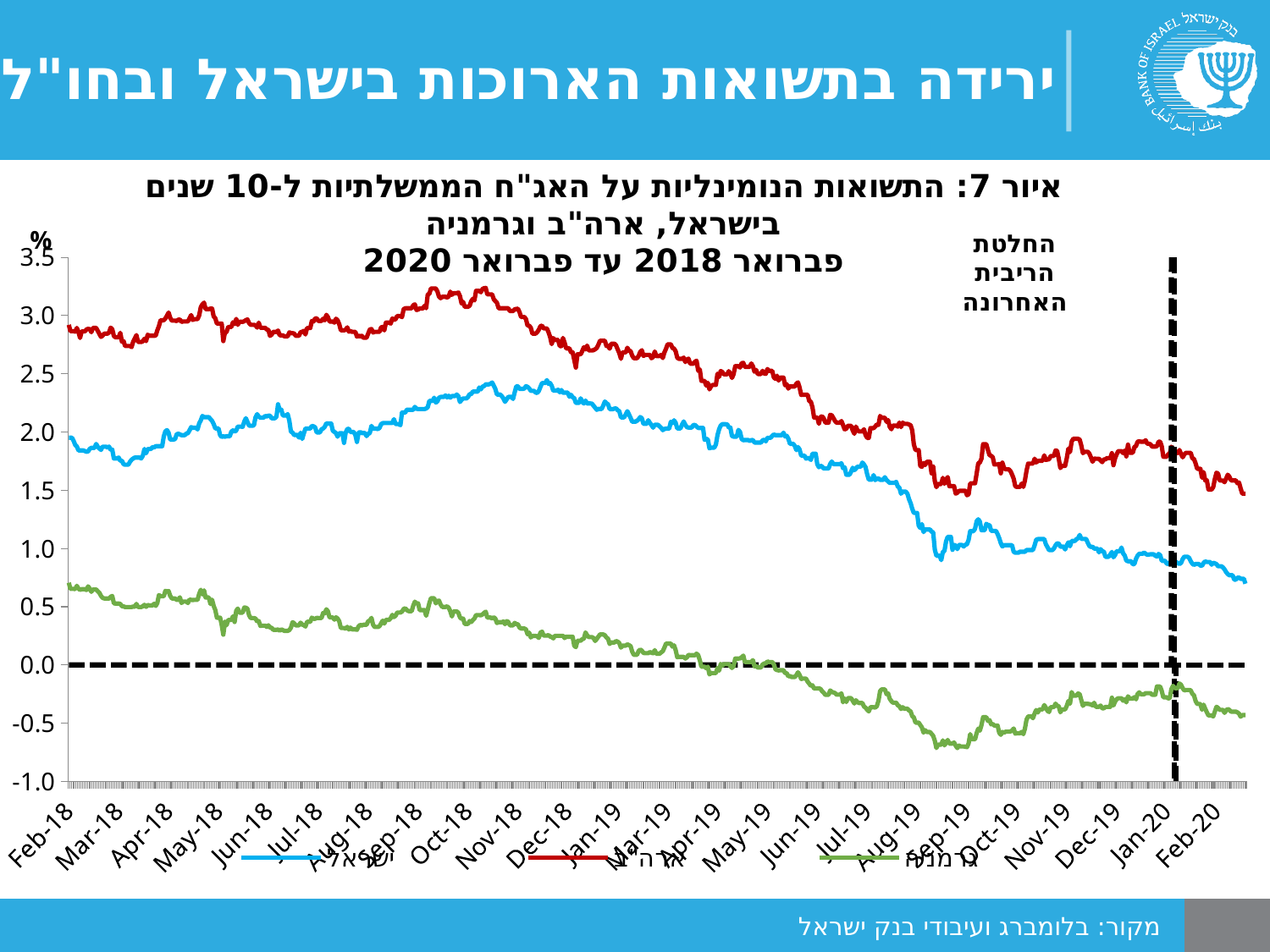
How many series (lines) are plotted in the chart? 3 Is the value of the blue line at Feb-20 greater or less than 1.0? less Which line is the lowest across the whole period: the red, blue or green line? green Do the values of the red line rise or fall overall from Feb-18 to Feb-20? fall At what value is the horizontal dashed line drawn on the chart? 0.0 Is the value of the green line at Feb-18 greater or less than 0.5? greater How many month labels are shown on the x axis? 25 Is the value of the green line at Sep-19 greater or less than -0.5? less Which line is the highest across the whole period: the red, blue or green line? red Do the values of the blue line rise or fall overall from Feb-18 to Feb-20? fall What kind of chart is shown on the slide? line chart